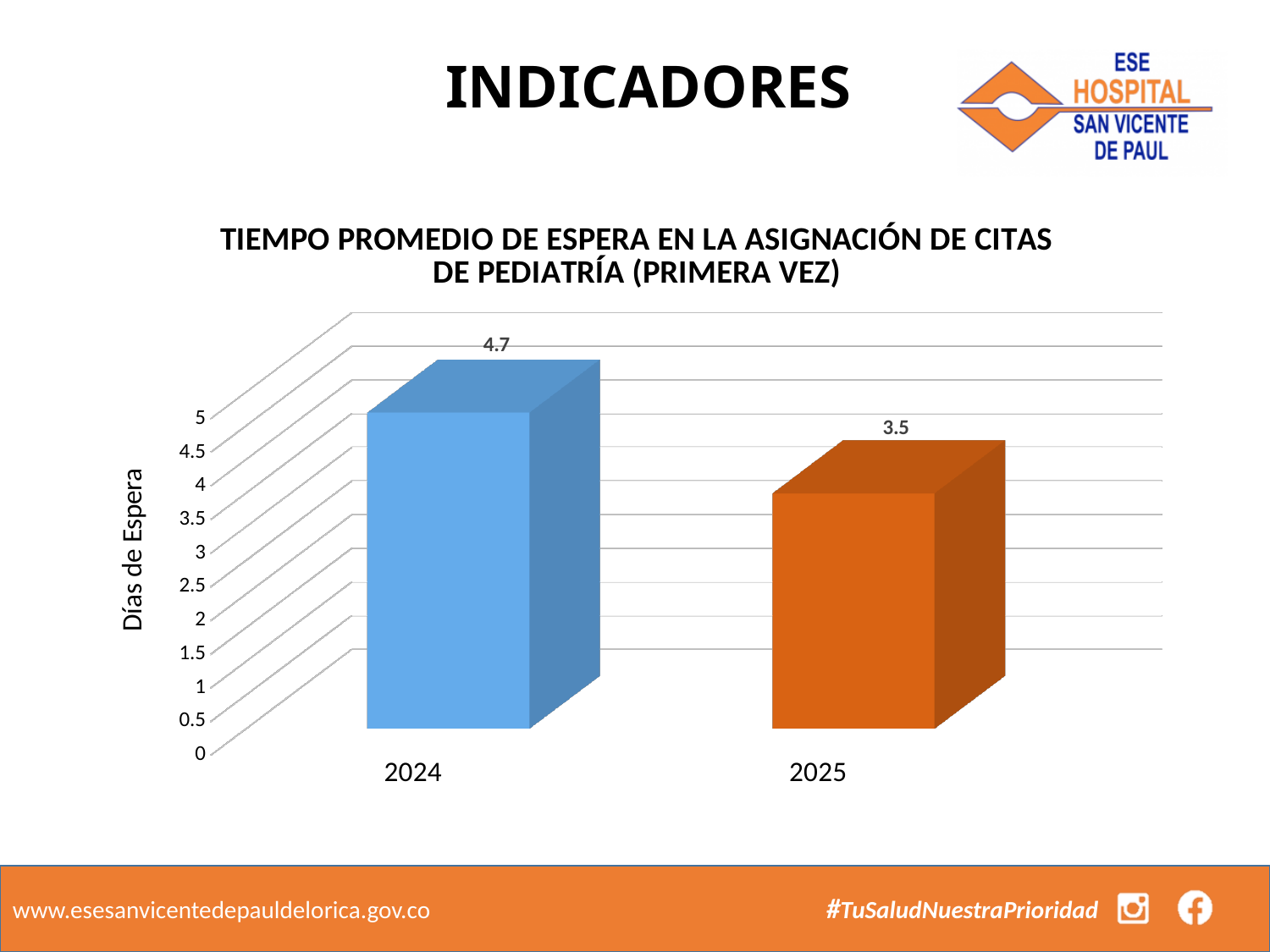
What is the average waiting time in days for 2025? 3.5 Which year has the lowest average waiting time? 2025 Is the value for 2024 greater or less than 4? greater What is the difference in waiting days between 2024 and 2025? 1.2 Which is larger, the value for 2024 or the value for 2025? 2024 Is the value for 2025 greater or less than 4? less What kind of chart is shown on the slide? bar chart What is the average waiting time in days for 2024? 4.7 What is the label of the vertical axis? Días de Espera How many years are shown on the chart? 2 Do the values rise or fall from 2024 to 2025? fall Which year has the highest average waiting time? 2024